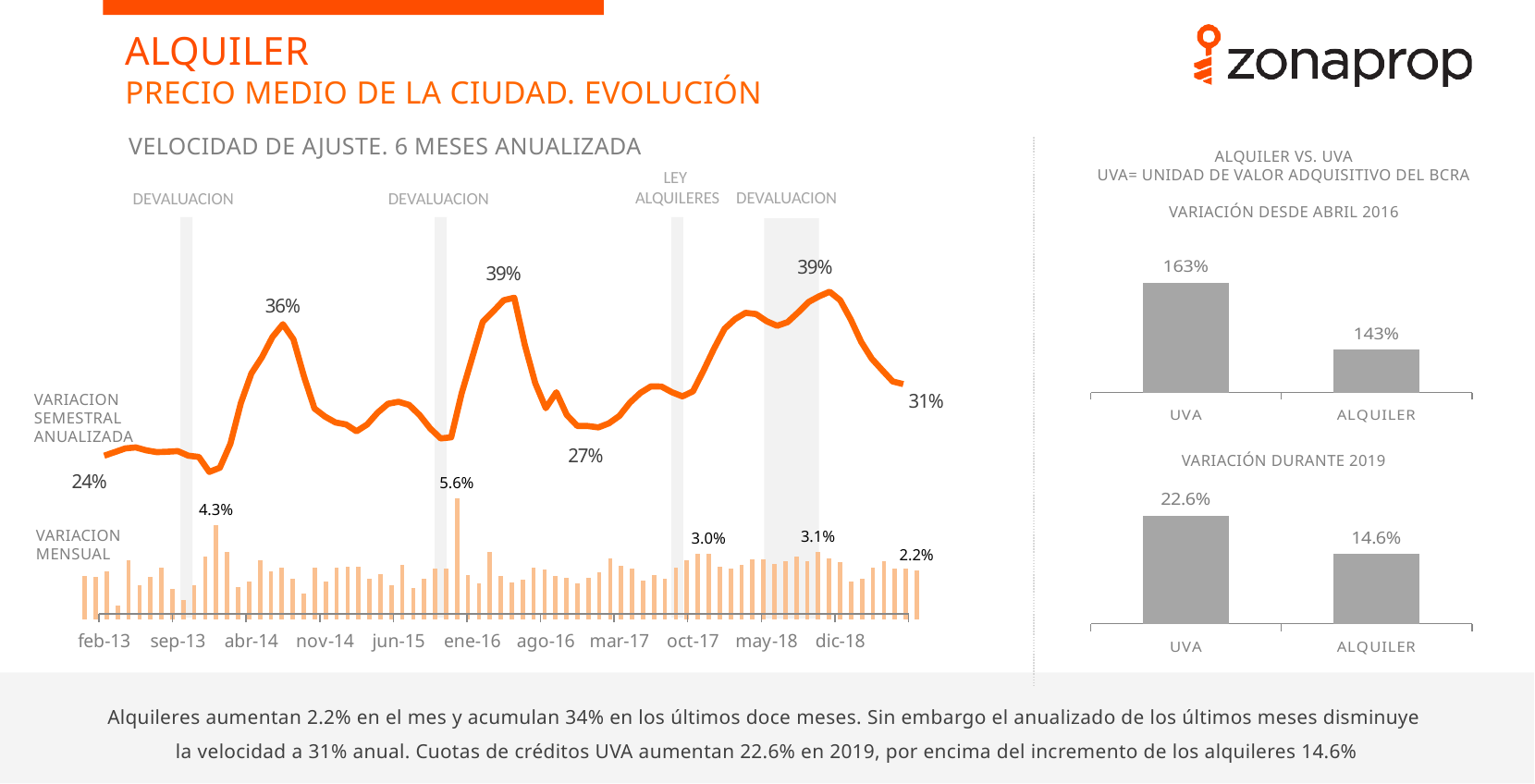
In the 'VELOCIDAD DE AJUSTE. 6 MESES ANUALIZADA' chart, what is the first labeled value of the annualized semiannual variation line, at feb-13? 24% In the 'VARIACIÓN DURANTE 2019' chart, what is the difference between UVA and ALQUILER? 8.0 percentage points How many categories does the 'VARIACIÓN DURANTE 2019' chart show? 2 In the 'VELOCIDAD DE AJUSTE. 6 MESES ANUALIZADA' chart, what is the highest labeled monthly variation? 5.6% In the 'VELOCIDAD DE AJUSTE. 6 MESES ANUALIZADA' chart, what is the last labeled value of the annualized semiannual variation line? 31% In the 'VARIACIÓN DURANTE 2019' chart, which category is higher, UVA or ALQUILER? UVA What kind of chart is the 'VARIACIÓN DESDE ABRIL 2016' chart? Bar chart In the 'VARIACIÓN DURANTE 2019' chart, what is the value for ALQUILER? 14.6% In the 'VARIACIÓN DESDE ABRIL 2016' chart, what is the value for UVA? 163% In the 'VARIACIÓN DESDE ABRIL 2016' chart, what is the difference between UVA and ALQUILER? 20 percentage points In the 'VARIACIÓN DESDE ABRIL 2016' chart, what is the value for ALQUILER? 143% In the 'VARIACIÓN DURANTE 2019' chart, what is the value for UVA? 22.6%